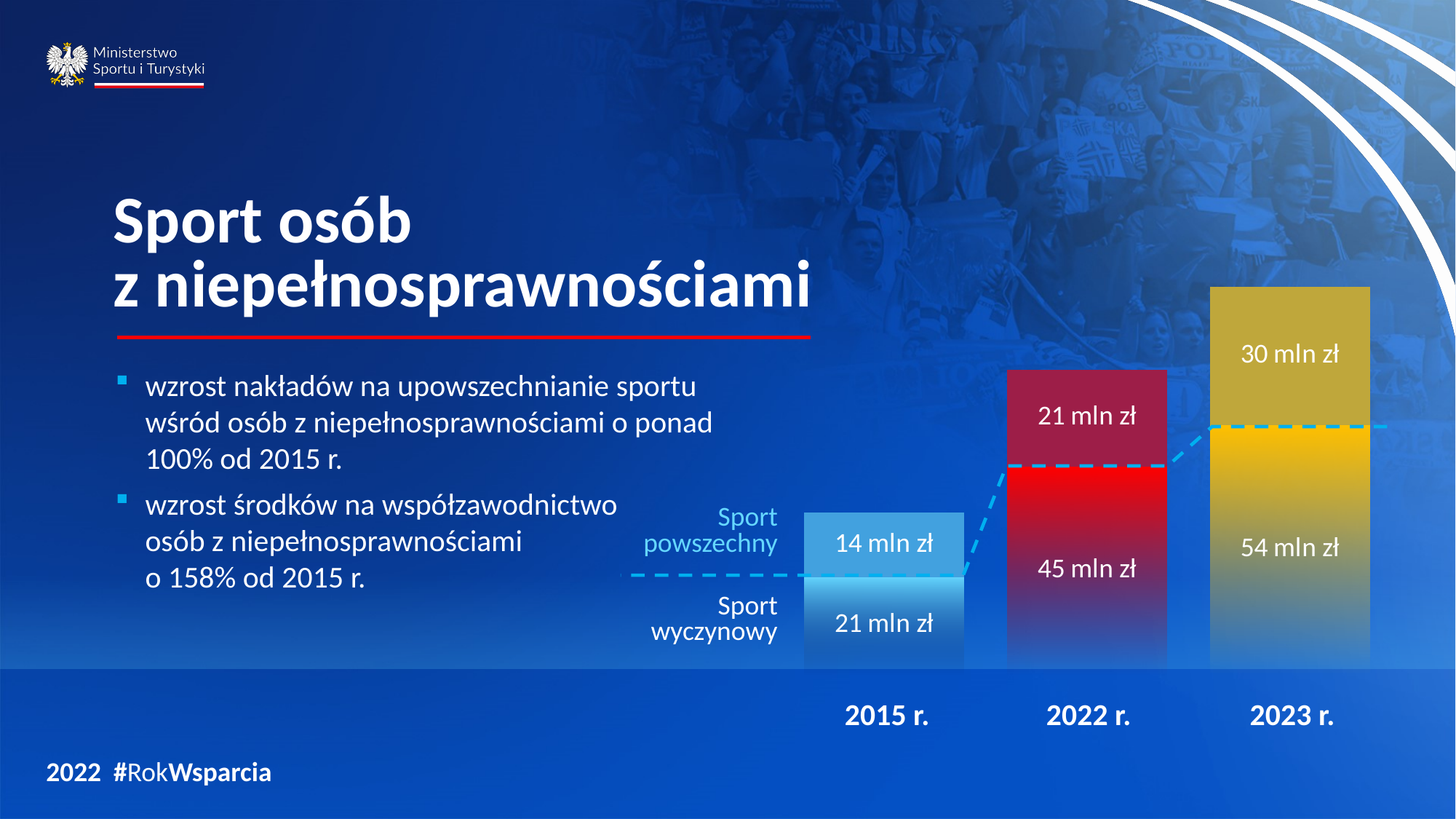
Which year has the lowest value for Sport powszechny? 2015 r. What is the total of the stacked bar for 2022 r.? 66 mln zł Which is larger: Sport powszechny in 2022 r. or Sport powszechny in 2023 r.? Sport powszechny in 2023 r. What is the value for Sport wyczynowy in 2022 r.? 45 mln zł What is the difference between the Sport wyczynowy values for 2023 r. and 2015 r.? 33 mln zł What kind of chart is shown on the slide? Stacked bar chart What is the value for Sport wyczynowy in 2023 r.? 54 mln zł Which year has the highest value for Sport wyczynowy? 2023 r. How many years are shown on the x axis of the chart? 3 What is the value for Sport powszechny in 2015 r.? 14 mln zł What is the value for Sport powszechny in 2023 r.? 30 mln zł What is the total of the stacked bar for 2023 r.? 84 mln zł